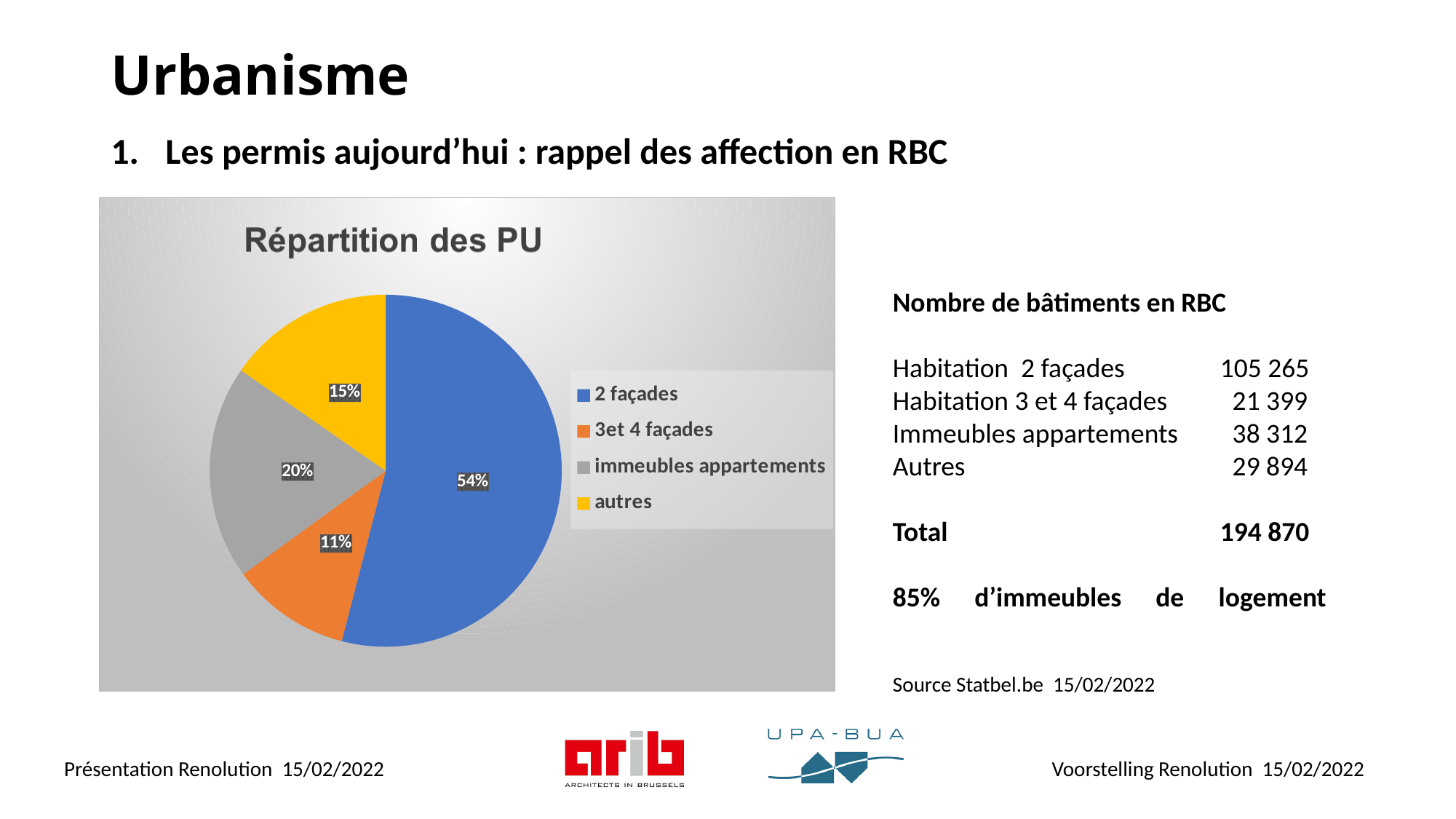
What share of the pie does the '2 façades' slice represent? 54% Which category has the smallest slice of the pie? 3et 4 façades Which slice is larger, 'autres' or '3et 4 façades'? autres What share of the pie does the 'autres' slice represent? 15% How many categories does the pie chart show? 4 What share of the pie does the 'immeubles appartements' slice represent? 20% Which category has the largest slice of the pie? 2 façades What is the title of the chart? Répartition des PU What type of chart is shown on the slide? pie chart What colour is the 'immeubles appartements' slice? grey What is the difference in percentage points between the '2 façades' slice and the 'immeubles appartements' slice? 34